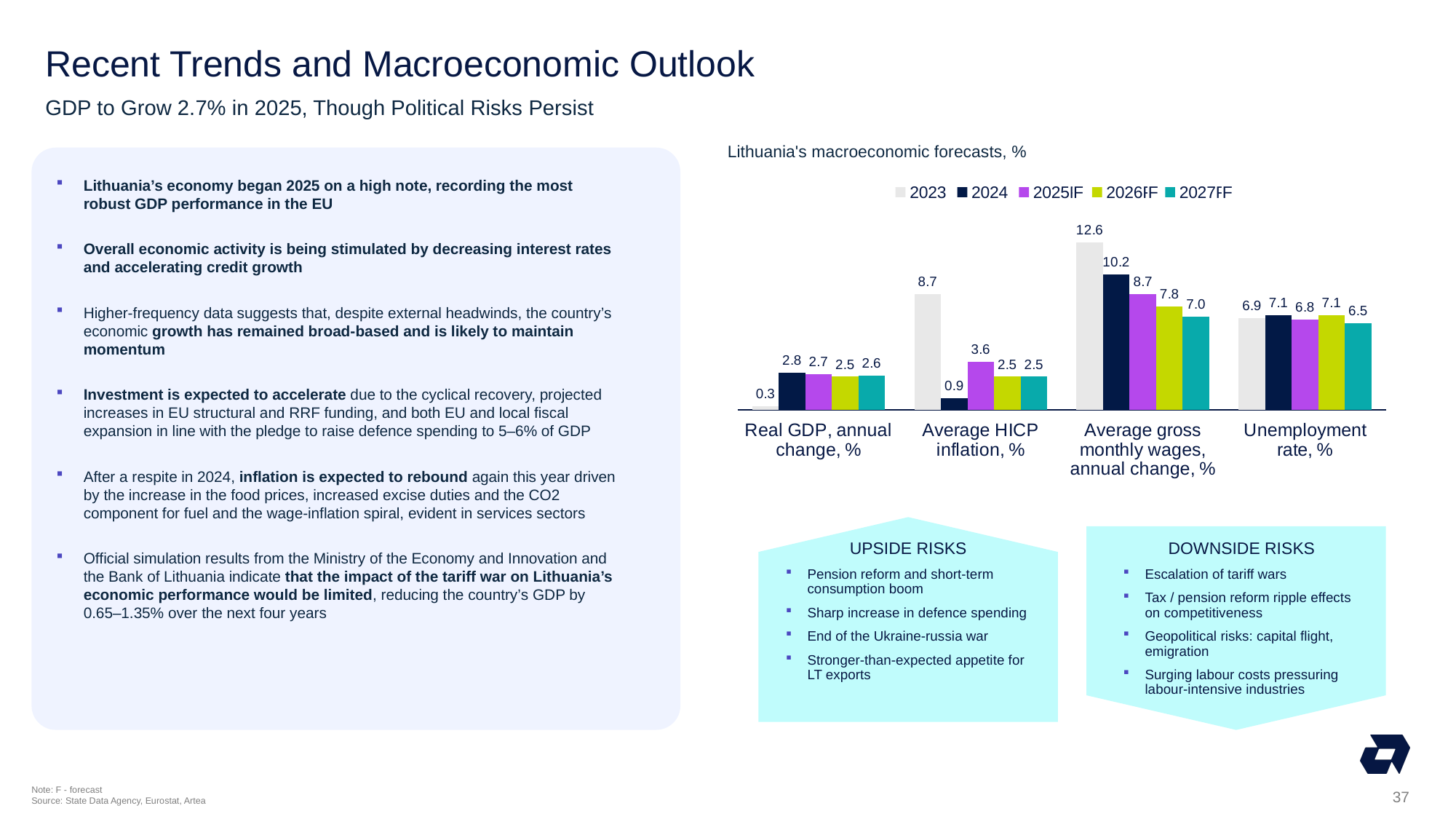
For Average gross monthly wages, annual change, %, which year has the highest value? 2023 For Unemployment rate, %, which year has the lowest value? 2027F How many indicator categories are shown on the x axis of the chart? 4 What type of chart is used to show Lithuania's macroeconomic forecasts? Bar chart How many series does the chart legend list? 5 What is the 2027F value for Average gross monthly wages, annual change, %? 7.0 What is the difference between the 2023 and 2024 values for Average gross monthly wages, annual change, %? 2.4 Do the values for Average gross monthly wages, annual change, % rise or fall from 2023 to 2027F? Fall For Average HICP inflation, %, which is larger: the 2025F value or the 2026F value? 2025F By how much does Real GDP, annual change, % in 2024 exceed the 2023 value? 2.5 What is the 2023 value for Average HICP inflation, %? 8.7 What is the value for Real GDP, annual change, % in 2024? 2.8